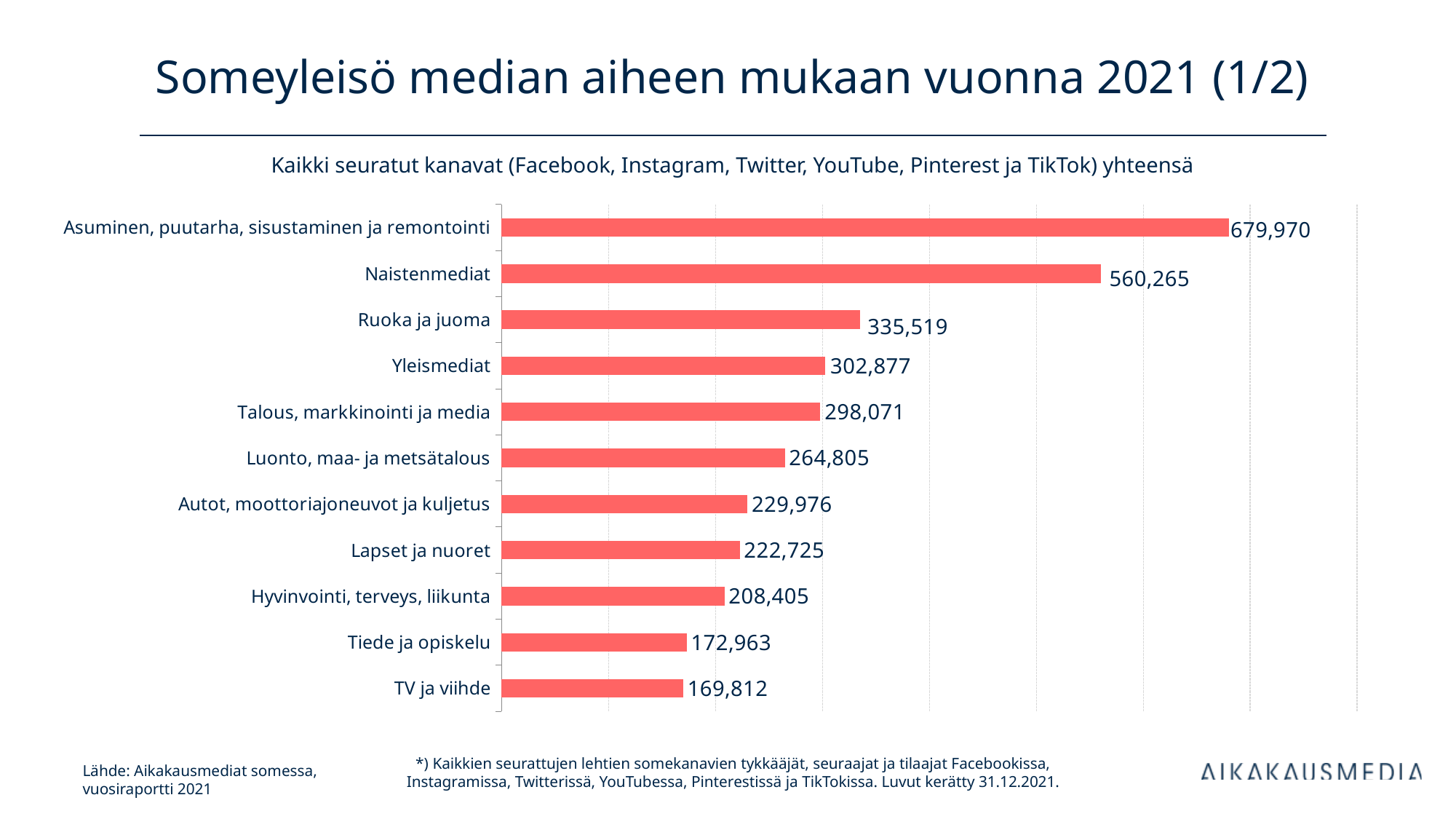
What is the title of the chart? Kaikki seuratut kanavat (Facebook, Instagram, Twitter, YouTube, Pinterest ja TikTok) yhteensä Which is larger, the value for Autot, moottoriajoneuvot ja kuljetus or the value for Hyvinvointi, terveys, liikunta? Autot, moottoriajoneuvot ja kuljetus What kind of chart is shown on the slide? Bar chart What is the value for Naistenmediat? 560,265 What is the value for Luonto, maa- ja metsätalous? 264,805 Which category has the lowest value? TV ja viihde How many categories are shown in the chart? 11 What is the value for TV ja viihde? 169,812 What is the difference between the values for Ruoka ja juoma and Yleismediat? 32,642 What colour are the bars in the chart? Red Which category has the highest value? Asuminen, puutarha, sisustaminen ja remontointi What is the difference between the values for Asuminen, puutarha, sisustaminen ja remontointi and Naistenmediat? 119,705